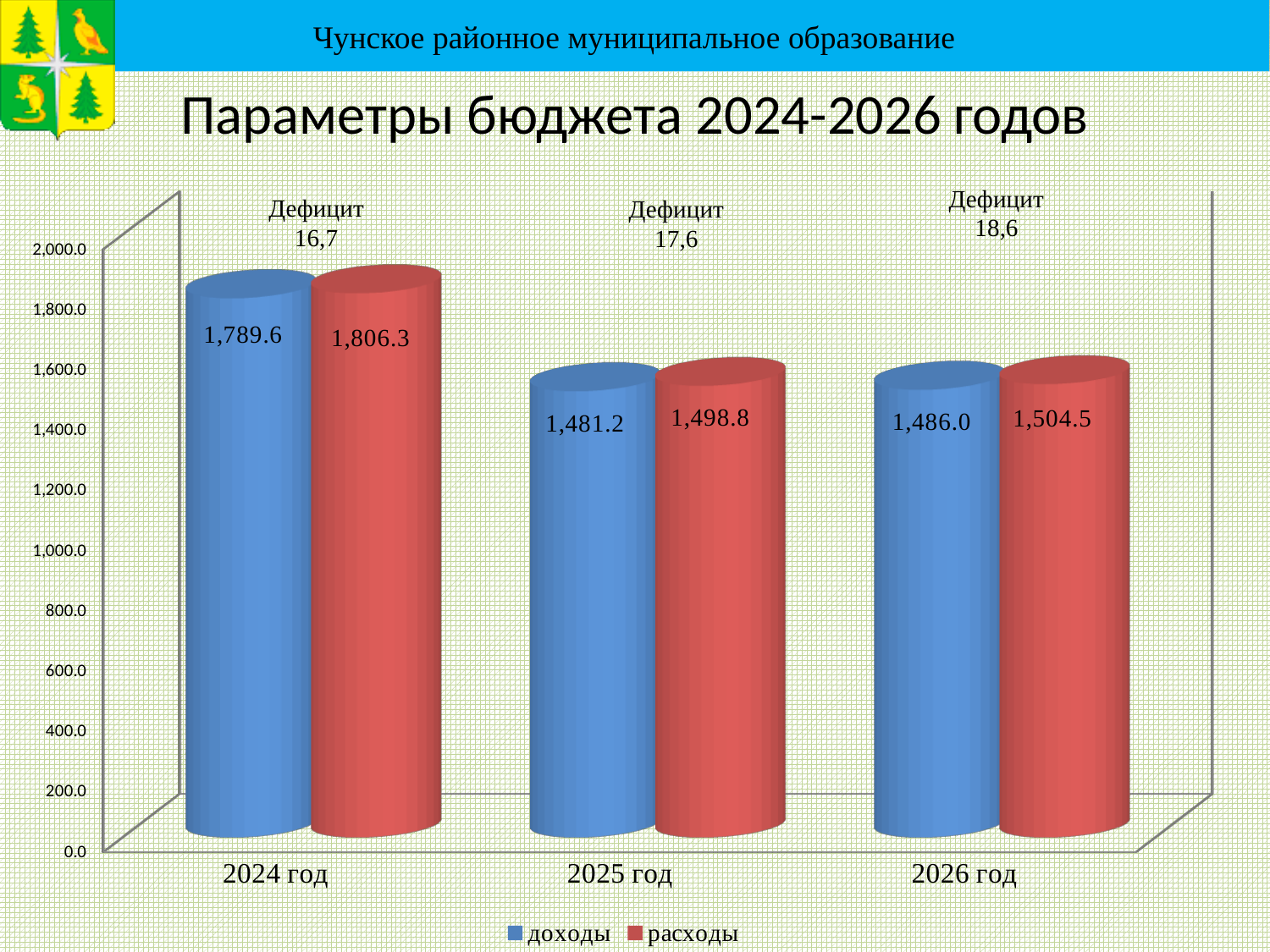
Which is larger for 2025 год, доходы or расходы? расходы Which year has the highest value of расходы? 2024 год How many years are shown on the x axis? 3 What deficit (Дефицит) is shown above the bars for 2026 год? 18,6 Which year has the lowest value of доходы? 2025 год What is the value of доходы for 2024 год? 1,789.6 What is the difference between расходы and доходы for 2024 год? 16.7 What is the value of доходы for 2026 год? 1,486.0 How many series does the legend list? 2 What is the value of расходы for 2026 год? 1,504.5 What kind of chart is shown on the slide? bar chart What is the value of расходы for 2025 год? 1,498.8